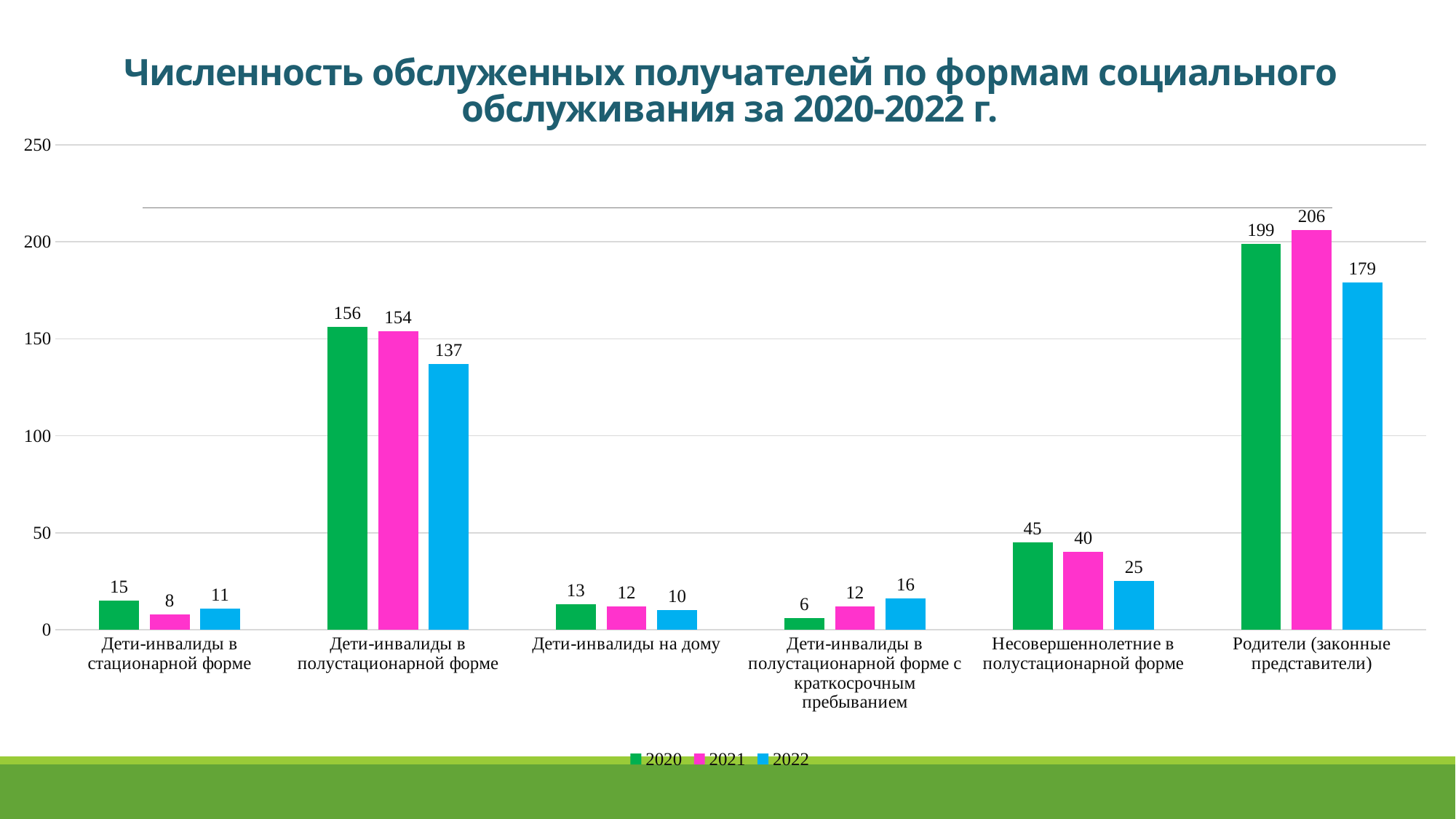
What is the value for 2020 in the category "Несовершеннолетние в полустационарной форме"? 45 What is the value for 2021 in the category "Родители (законные представители)"? 206 What kind of chart is shown on the slide? bar chart What is the difference between the 2020 and 2022 values for "Родители (законные представители)"? 20 Is the 2021 value for "Дети-инвалиды в полустационарной форме" greater or less than 100? greater Which category has the lowest value for 2020? Дети-инвалиды в полустационарной форме с краткосрочным пребыванием Which category has the highest value for 2022? Родители (законные представители) Which is larger for "Дети-инвалиды в стационарной форме": the 2020 value or the 2021 value? 2020 Do the values for "Несовершеннолетние в полустационарной форме" rise or fall from 2020 to 2022? fall How many series does the legend list? 3 How many categories are shown on the x axis? 6 What is the value for 2022 in the category "Дети-инвалиды в полустационарной форме"? 137